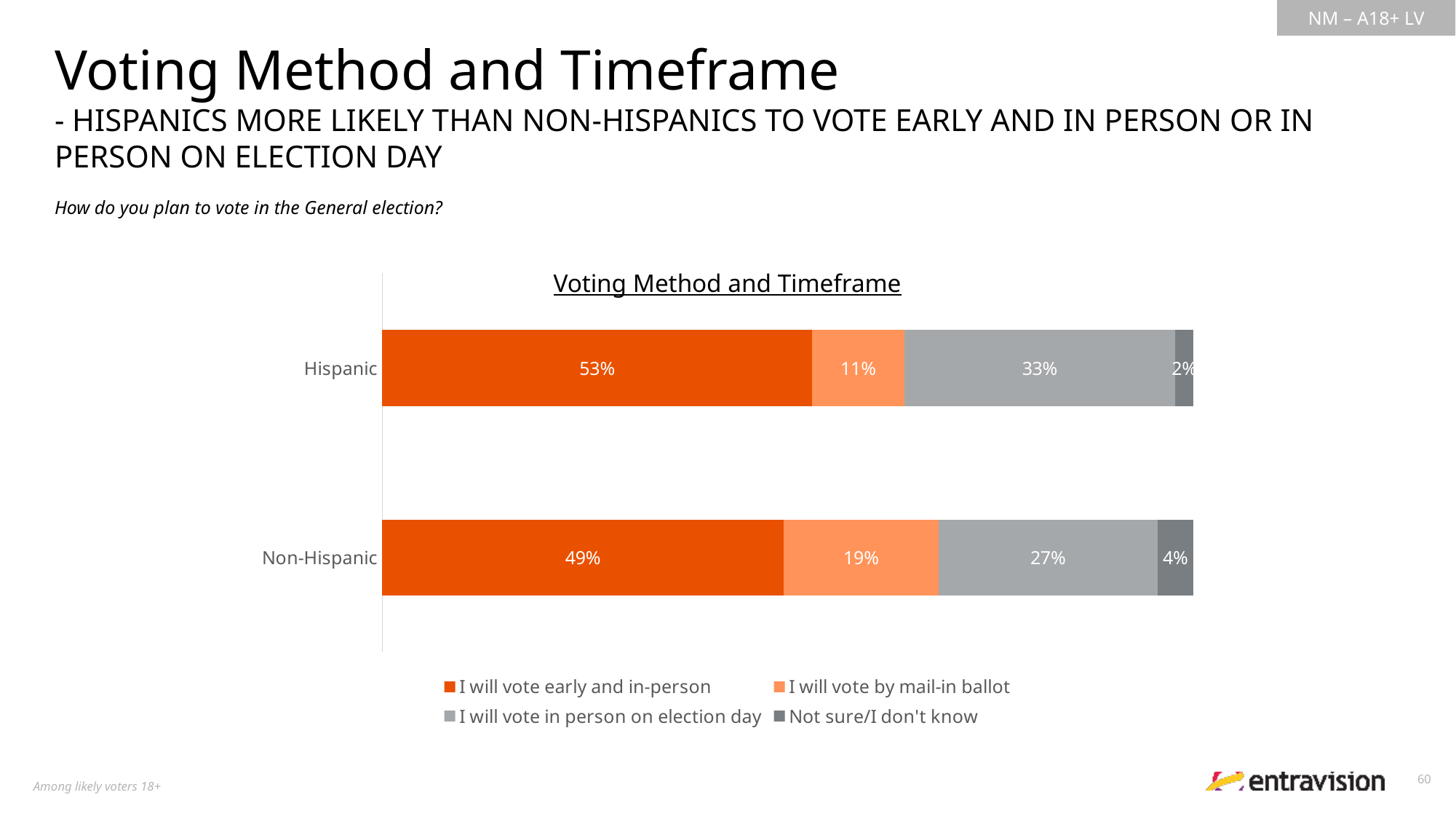
What kind of chart is shown on the slide? Stacked bar chart What percentage of Hispanic respondents said they will vote early and in-person? 53% What percentage of Non-Hispanic respondents said they will vote by mail-in ballot? 19% How many series does the legend list? 4 What is the difference in percentage points between Hispanic and Non-Hispanic respondents who will vote early and in-person? 4 percentage points What percentage of Hispanic respondents said they will vote in person on election day? 33% Which group has the higher share saying they will vote in person on election day, Hispanic or Non-Hispanic? Hispanic How many groups (categories) are shown on the chart? 2 Which group has the higher share saying they will vote by mail-in ballot, Hispanic or Non-Hispanic? Non-Hispanic What is the difference in percentage points between Non-Hispanic and Hispanic respondents who will vote by mail-in ballot? 8 percentage points What percentage of Non-Hispanic respondents answered Not sure/I don't know? 4% Which voting method is the largest segment for both Hispanic and Non-Hispanic respondents? I will vote early and in-person